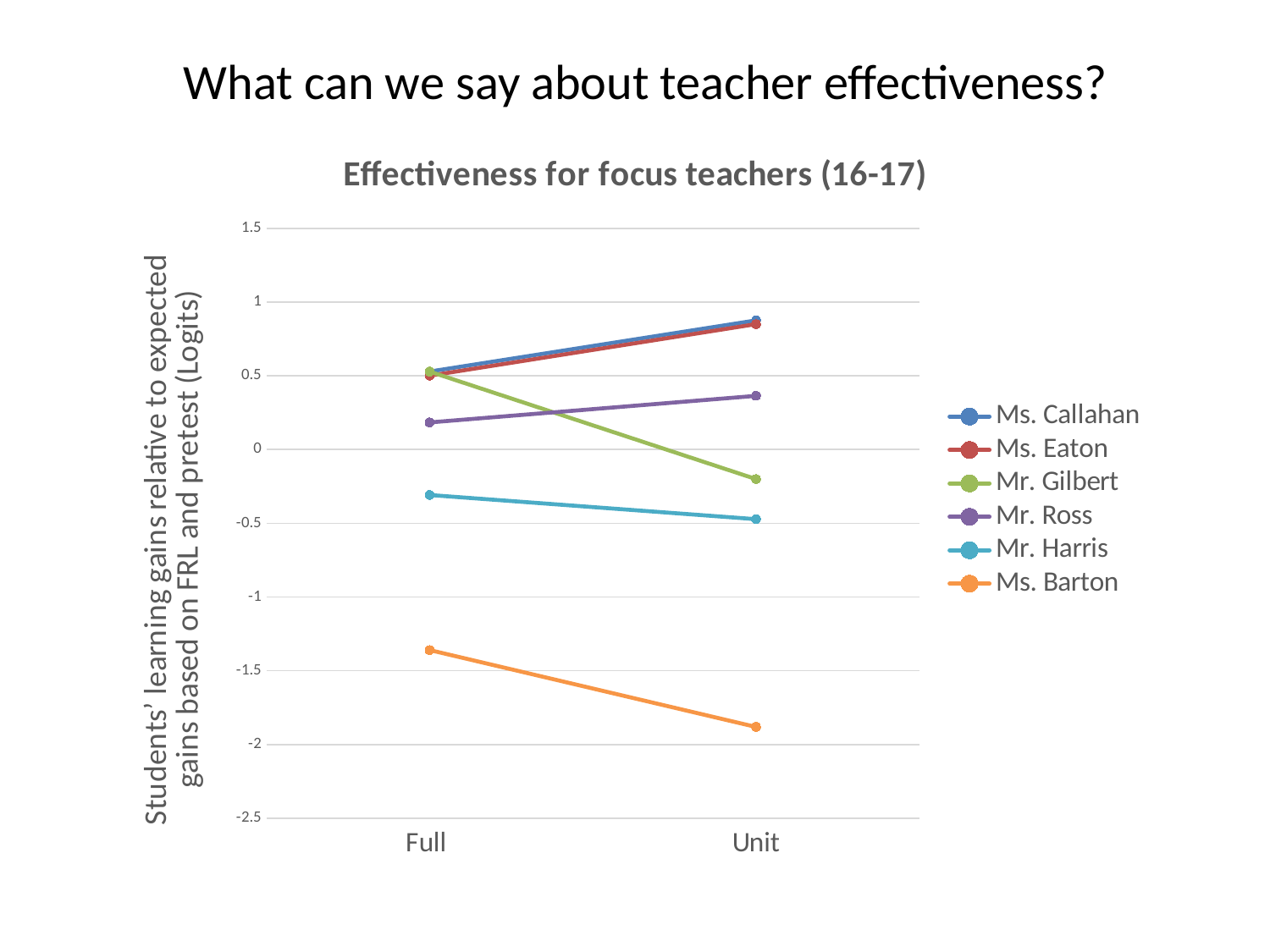
Does the line for Mr. Ross rise or fall from Full to Unit? Rise Does the line for Mr. Gilbert rise or fall from Full to Unit? Fall Is the value for Ms. Barton at Unit greater or less than -1.5? less What is the title of the chart? Effectiveness for focus teachers (16-17) How many teachers (series) does the legend list? 6 Which teacher has the lowest value at Full? Ms. Barton What kind of chart is shown on the slide? Line chart At Unit, which is larger: the value for Mr. Ross or the value for Mr. Harris? Mr. Ross Which teacher has the lowest value at Unit? Ms. Barton How many categories are shown on the x axis? 2 Is the value for Mr. Gilbert at Unit greater or less than 0? less Does the line for Ms. Barton rise or fall from Full to Unit? Fall